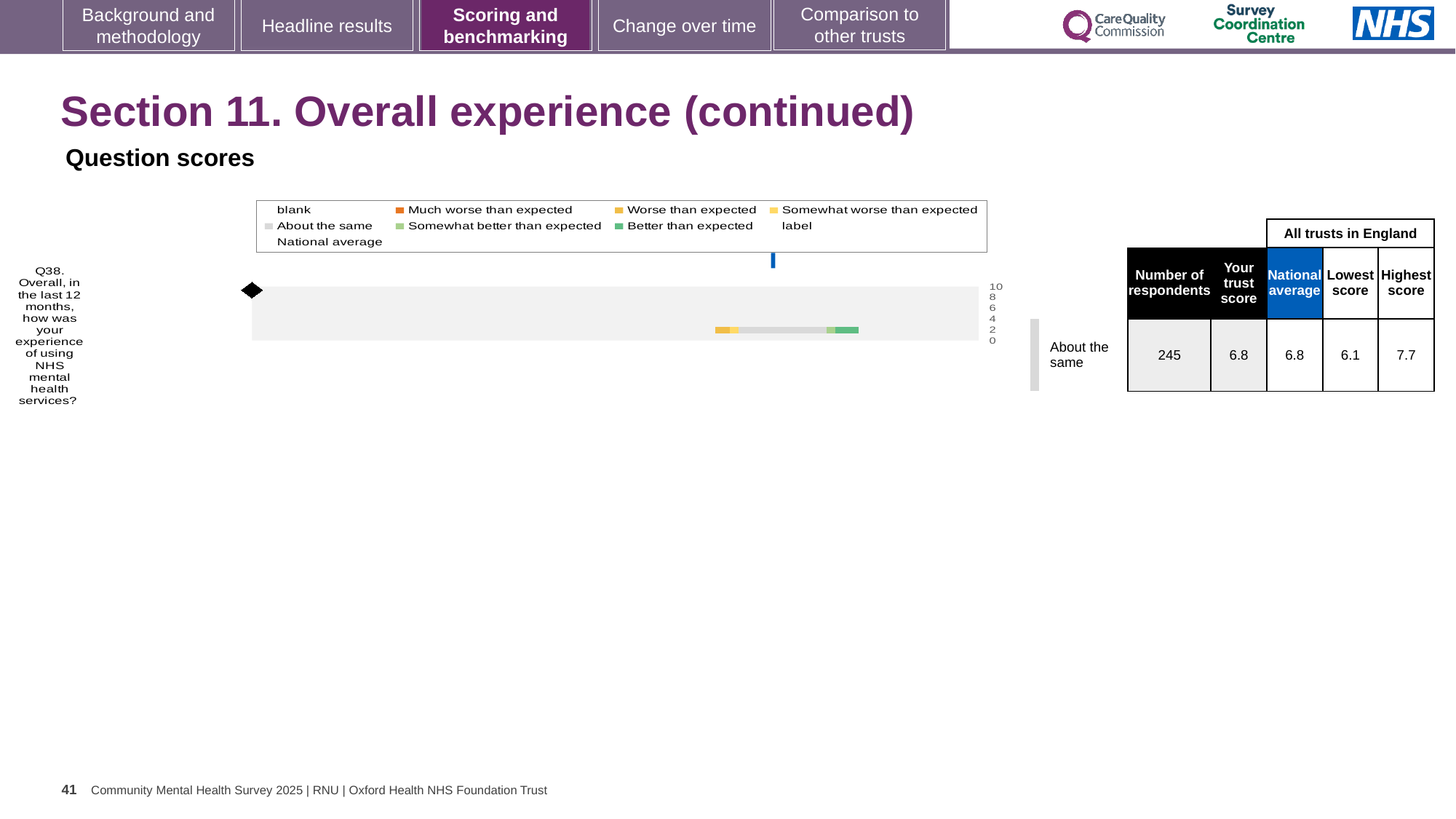
Which legend entry is shown in orange? Much worse than expected Which legend entry is shown in dark green? Better than expected How many respondents answered Q38? 245 What is the trust score for Q38 (overall experience of using NHS mental health services)? 6.8 What kind of chart is shown on the slide? bar chart How many survey questions are plotted in the chart? 1 What is the difference between the highest and lowest trust scores for Q38? 1.6 What is the highest score among all trusts in England for Q38? 7.7 What is the national average score for Q38? 6.8 Is the trust score for Q38 higher than, lower than, or the same as the national average? the same What is the lowest score among all trusts in England for Q38? 6.1 What benchmark category is the trust's Q38 score placed in? About the same